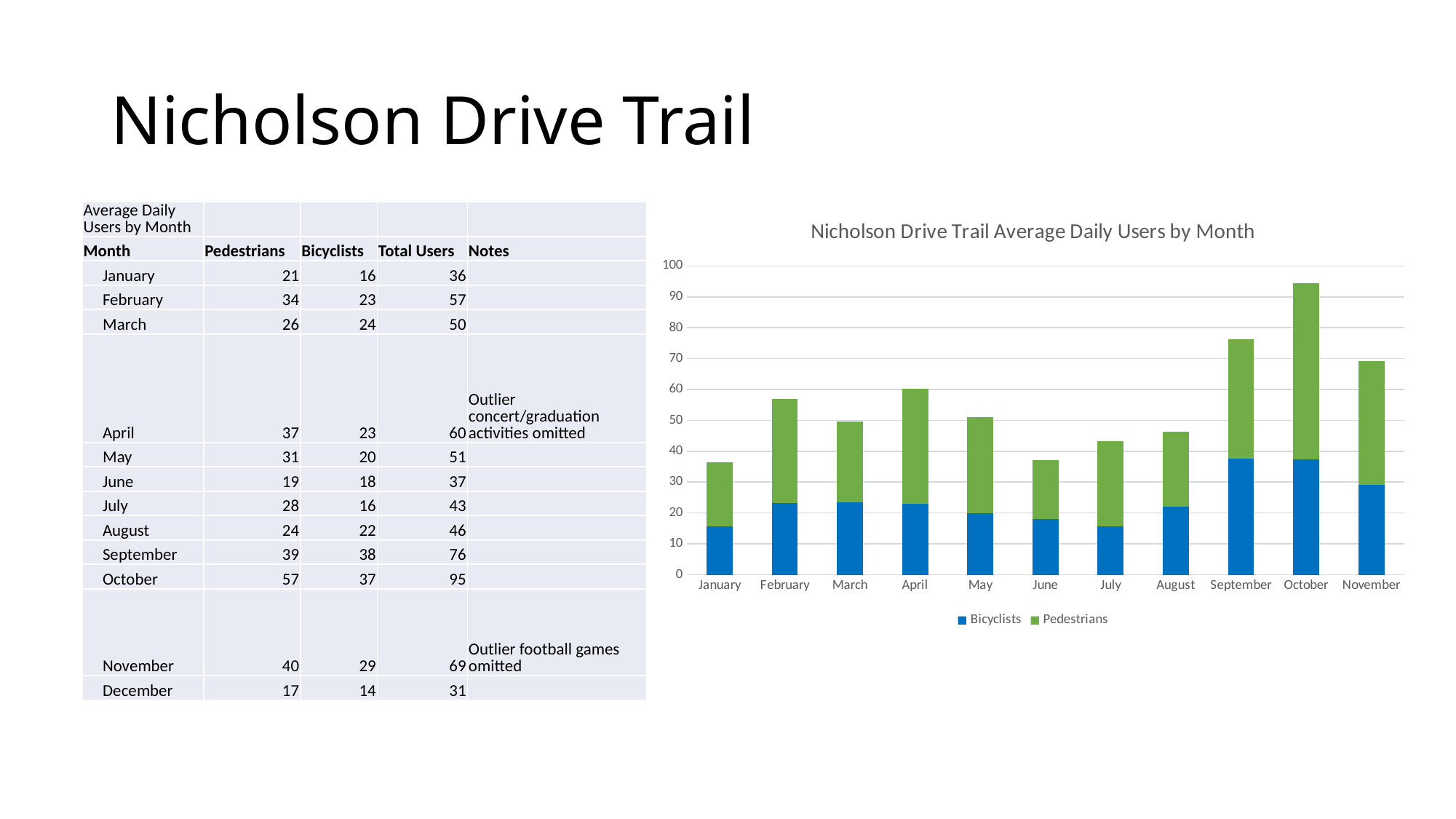
Which month has the highest total bar in the chart? October How many months are plotted on the x axis of the chart? 11 What kind of chart is shown on the slide? Stacked bar chart Which month has the largest Pedestrians segment in the chart? October Is the Bicyclists segment for September greater or less than 30? greater Which month has a taller total bar, September or February? September Is the total bar for October greater or less than 90? greater What is the difference between the total users for October and September as printed on the slide? 19 Is the total bar for June greater or less than 40? less How many series does the chart legend list? 2 According to the slide, what is the total number of average daily users for October? 95 Which colour represents Bicyclists in the chart legend? Blue